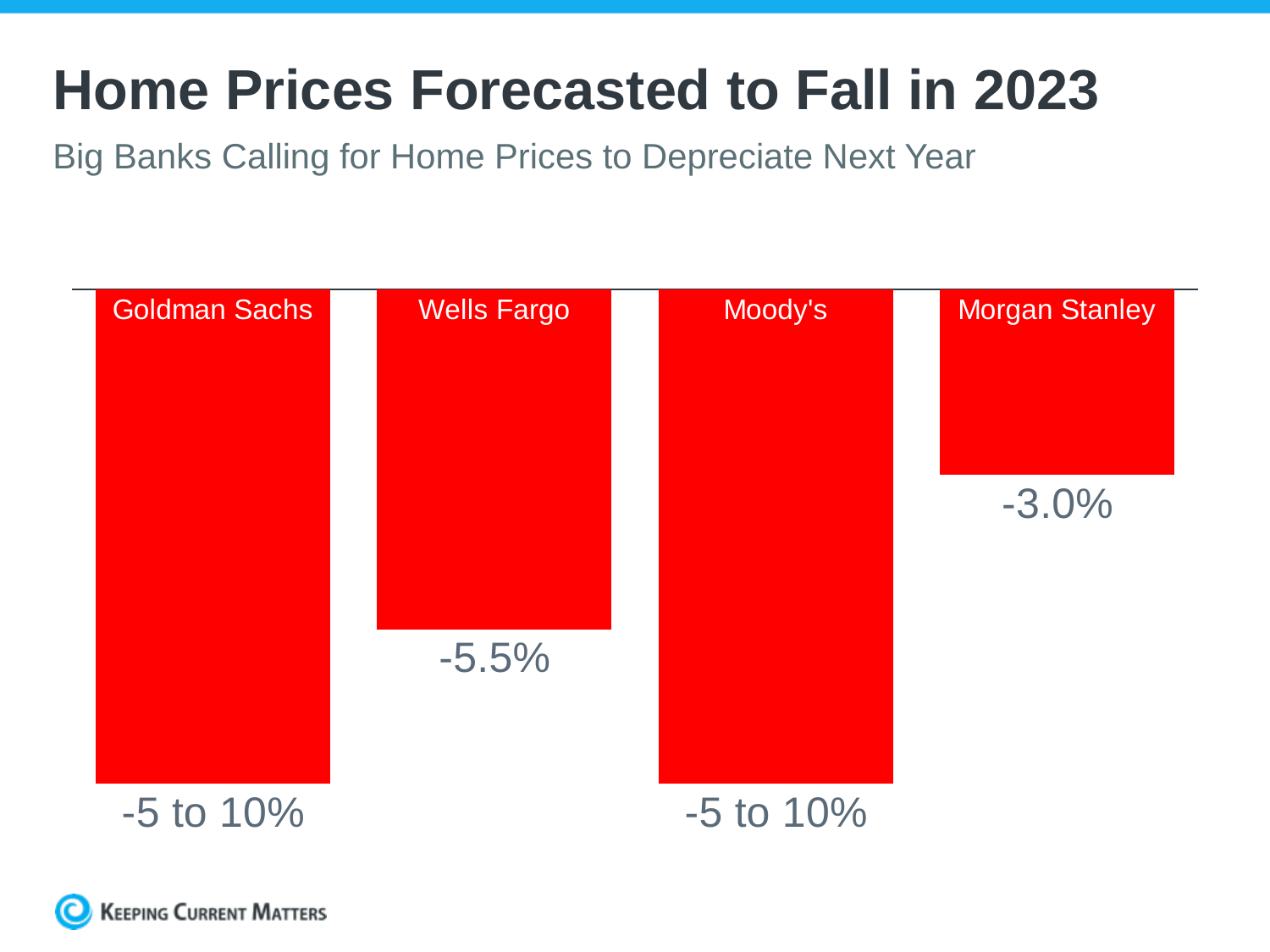
What is the forecasted home price change shown for Moody's? -5 to 10% How many banks are shown in the chart? 4 What is the forecasted home price change shown for Wells Fargo? -5.5% What colour are the bars in the chart? Red What is the forecasted home price change shown for Morgan Stanley? -3.0% By how many percentage points does the Wells Fargo forecast (-5.5%) differ from the Morgan Stanley forecast (-3.0%)? 2.5 percentage points What is the title of the slide containing the chart? Home Prices Forecasted to Fall in 2023 What kind of chart is shown on the slide? Bar chart Which bank's bar shows the smallest forecasted decline in home prices? Morgan Stanley Which bar is longer, Wells Fargo or Morgan Stanley? Wells Fargo What is the forecasted home price change shown for Goldman Sachs? -5 to 10%